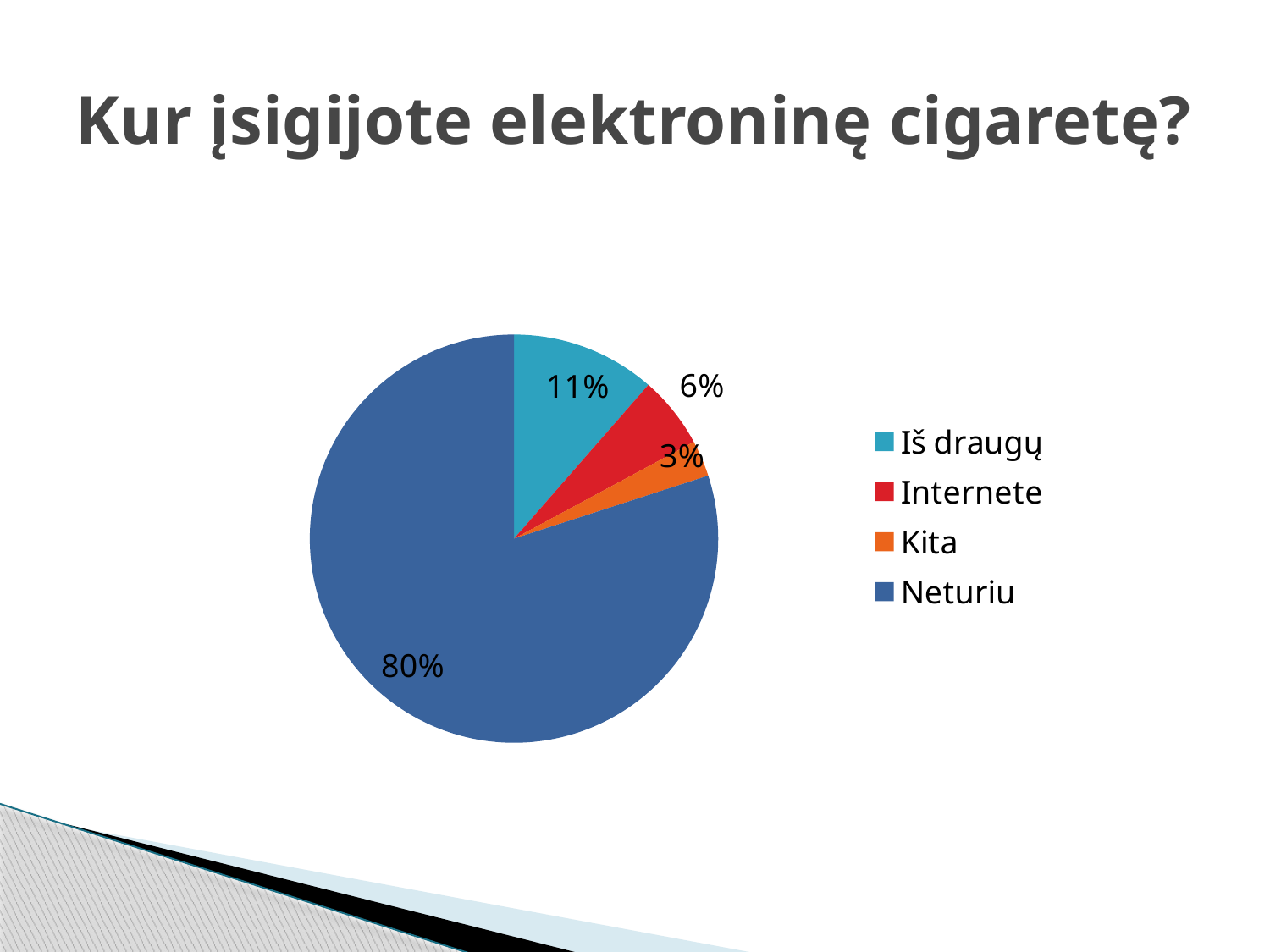
What share of the pie does the Internete slice represent? 6% What is the difference in percentage points between the Neturiu slice and the Iš draugų slice? 69% What share of the pie does the Neturiu slice represent? 80% Which category has the smallest slice of the pie? Kita How many categories does the pie chart show? 4 What share of the pie does the Kita slice represent? 3% What kind of chart is shown on the slide? Pie chart Which category has the largest slice of the pie? Neturiu Which is larger, the Internete slice or the Kita slice? Internete What is the title of the slide containing the chart? Kur įsigijote elektroninę cigaretę? What is the difference in percentage points between the Iš draugų slice and the Internete slice? 5%